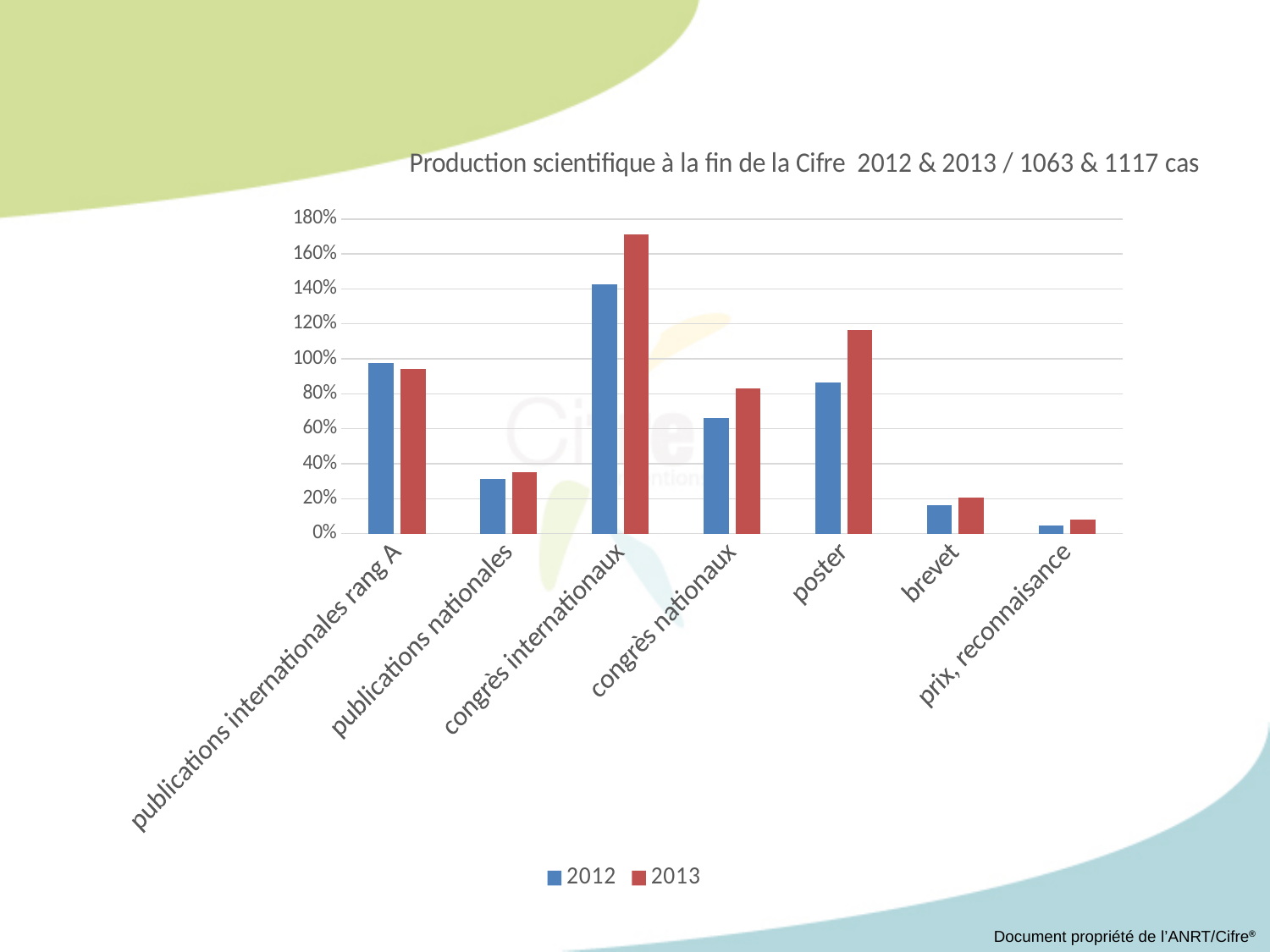
Is the value for congrès internationaux in 2013 greater or less than 160%? greater What kind of chart is shown on the slide? bar chart For poster, which year has the larger value, 2012 or 2013? 2013 Which category has the lowest value for 2012? prix, reconnaisance Is the value for brevet in 2012 greater or less than 20%? less For congrès nationaux, which year has the larger value, 2012 or 2013? 2013 Is the value for congrès internationaux in 2012 greater or less than 120%? greater How many series does the legend list? 2 What is the title of the chart? Production scientifique à la fin de la Cifre 2012 & 2013 / 1063 & 1117 cas Which category has the highest value for 2013? congrès internationaux How many categories are shown on the x axis? 7